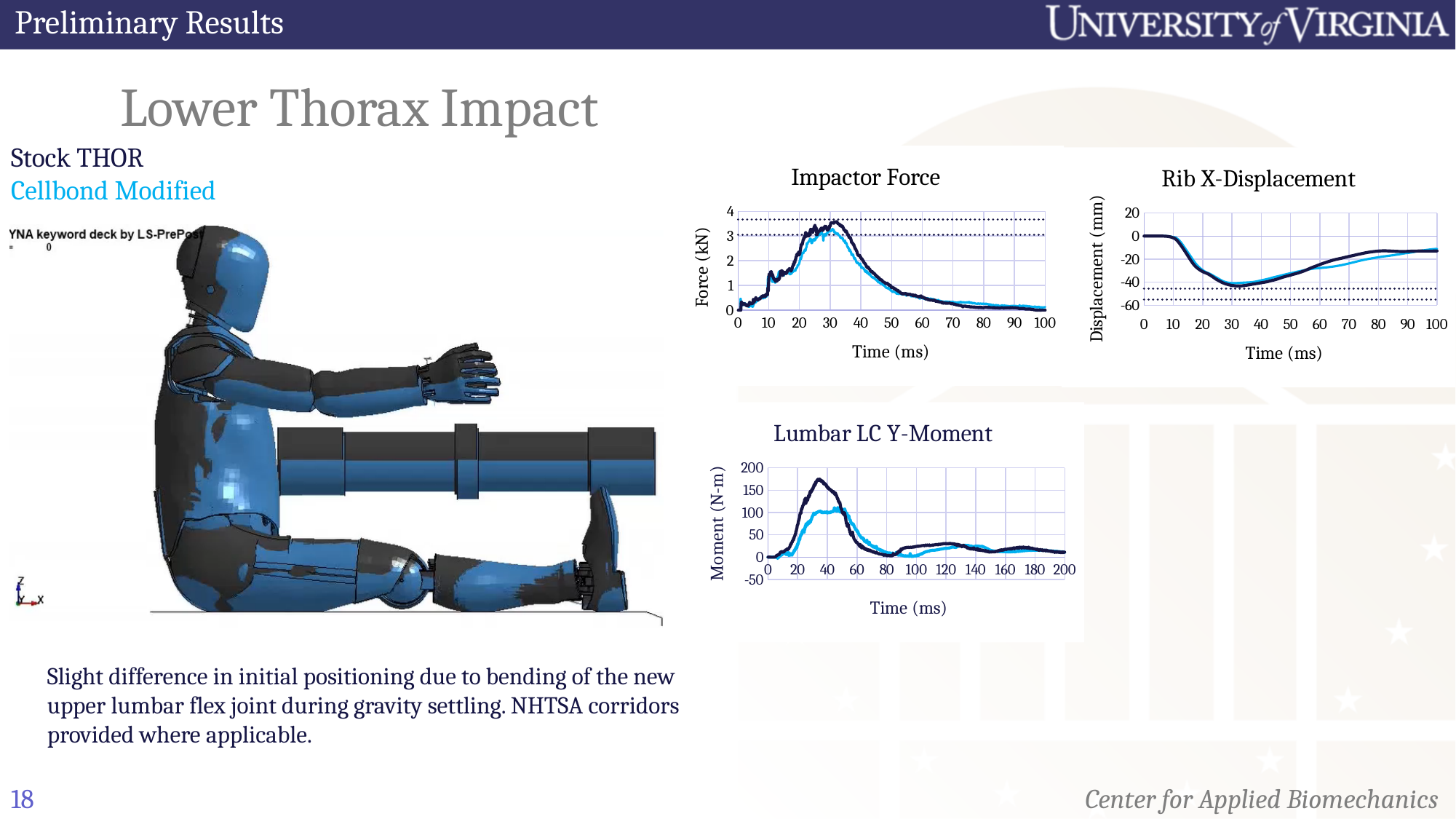
In the Lumbar LC Y-Moment chart, which series reaches the higher peak moment, Stock THOR or Cellbond Modified? Stock THOR What is the y-axis title of the Rib X-Displacement chart? Displacement (mm) What is the x-axis title of the Lumbar LC Y-Moment chart? Time (ms) In the Lumbar LC Y-Moment chart, is the peak moment of the Stock THOR series greater or less than 150 N-m? greater In the Impactor Force chart, is the force at 100 ms greater or less than 1 kN? less In the Lumbar LC Y-Moment chart, is the peak moment of the Cellbond Modified series greater or less than 150 N-m? less How many series are plotted in the Lumbar LC Y-Moment chart? 2 In the Rib X-Displacement chart, does the displacement rise or fall between 10 ms and 30 ms? fall What kind of chart is the Impactor Force chart? line chart In the Impactor Force chart, does the force rise or fall between 40 ms and 70 ms? fall